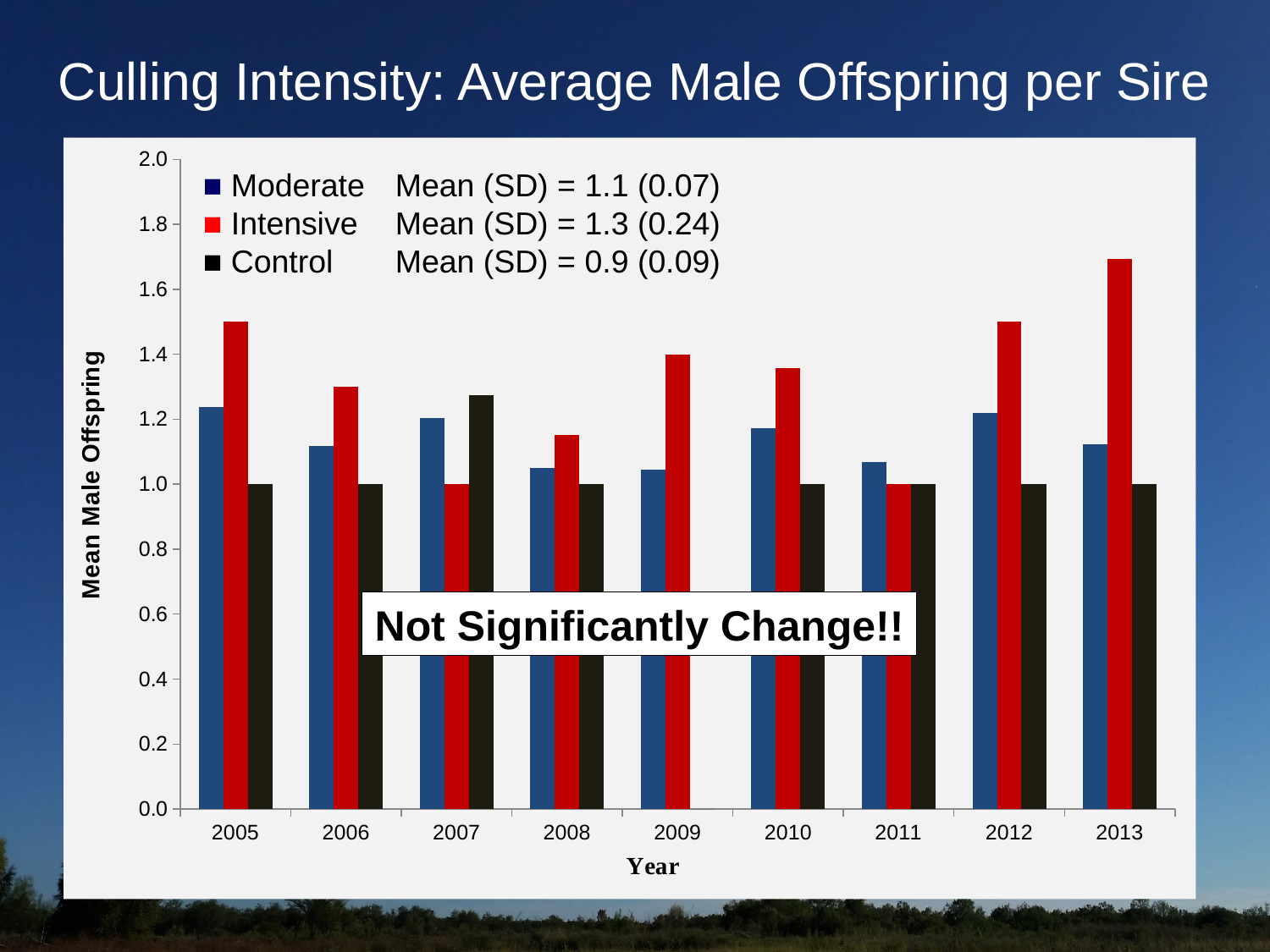
In 2007, which is larger: Control or Intensive? Control What is the Mean (SD) given in the legend for Intensive? 1.3 (0.24) How many years are shown on the x axis? 9 What is the value for Intensive in 2007? 1.0 In 2013, which is larger: Moderate or Intensive? Intensive Is the value for Control in 2007 greater or less than 1.2? greater Is the value for Intensive in 2013 greater or less than 1.6? greater Is the value for Moderate in 2005 greater or less than 1.2? greater In which year is the Intensive bar highest? 2013 How many series does the legend list? 3 What is the value for Control in 2005? 1.0 What kind of chart is shown on the slide? bar chart